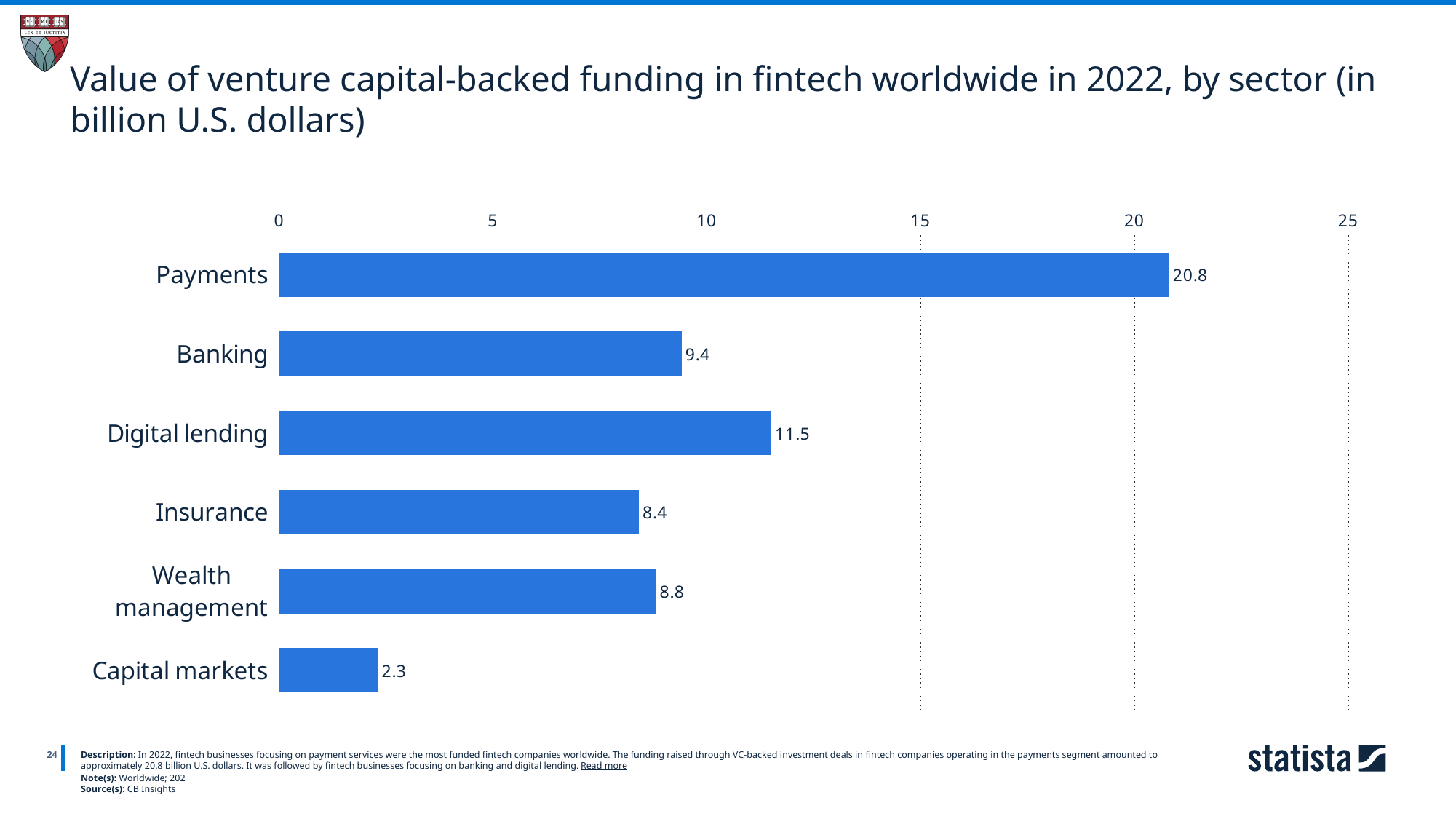
What is the difference between the values for Payments and Banking? 11.4 How many sectors are shown in the chart? 6 What kind of chart is shown on the slide? Bar chart Which sector has the highest value of venture capital-backed funding? Payments What is the value shown for Wealth management? 8.8 What is the source cited for the chart? CB Insights Which sector has the lowest value of venture capital-backed funding? Capital markets What is the value shown for Digital lending? 11.5 Is the value for Insurance greater or less than 10? less Which has a larger value, Banking or Digital lending? Digital lending What is the value of venture capital-backed funding for Payments? 20.8 What is the difference between the values for Digital lending and Insurance? 3.1